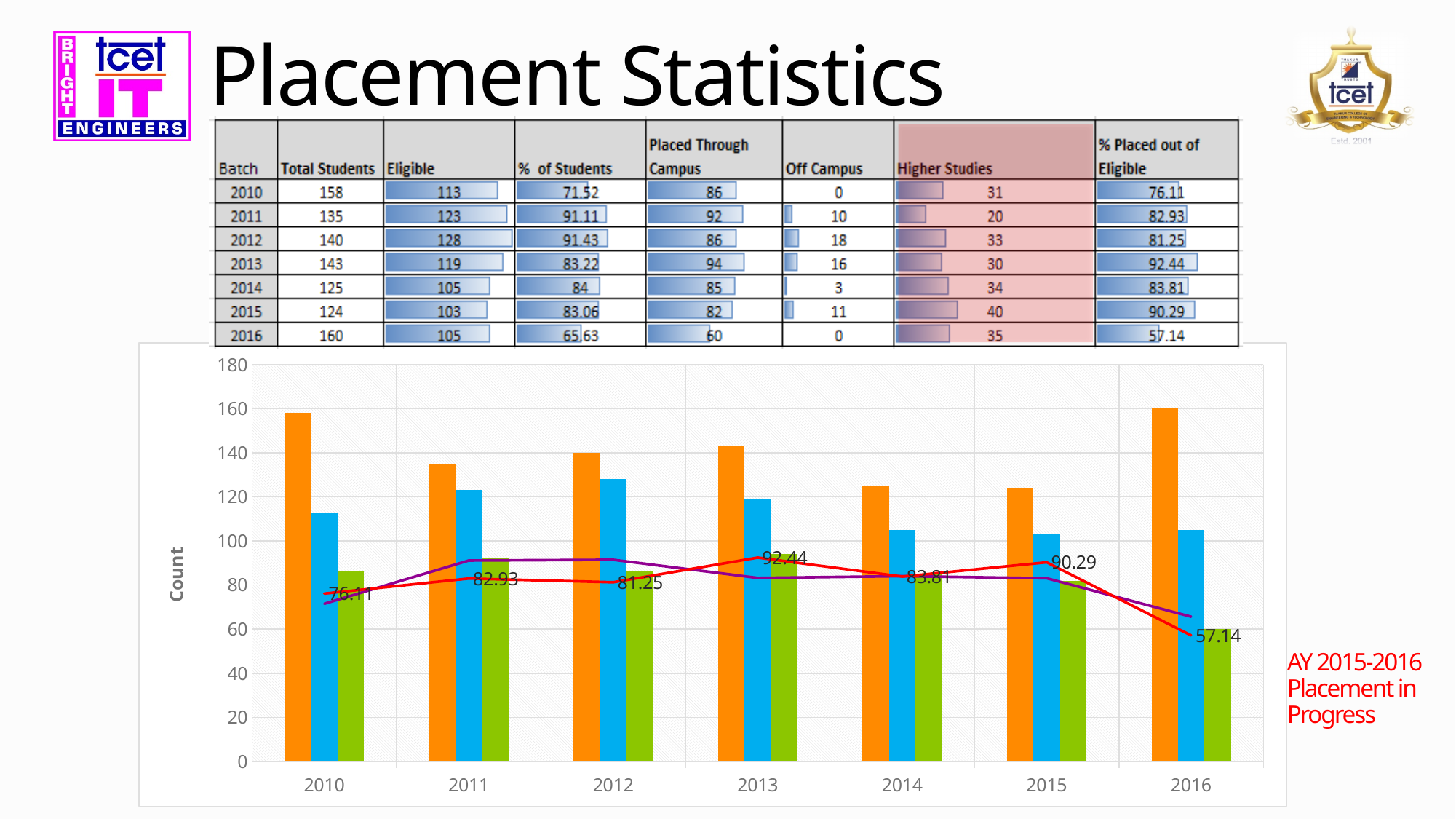
Is the value of the green bar for 2016 greater or less than 80? less Which is larger, the red line label for 2011 or for 2012? 2011 How many years are shown on the x axis of the chart? 7 Which year has the highest labelled value on the red line? 2013 What is the y-axis title of the chart? Count Which year has the lowest labelled value on the red line? 2016 What value is labelled on the red line for 2016? 57.14 What kind of chart is shown on the slide? bar and line chart Is the value of the orange bar for 2010 greater or less than 140? greater Does the red line rise or fall from 2015 to 2016? fall What value is labelled on the red line for 2013? 92.44 What is the difference between the red line labels for 2013 and 2016? 35.30